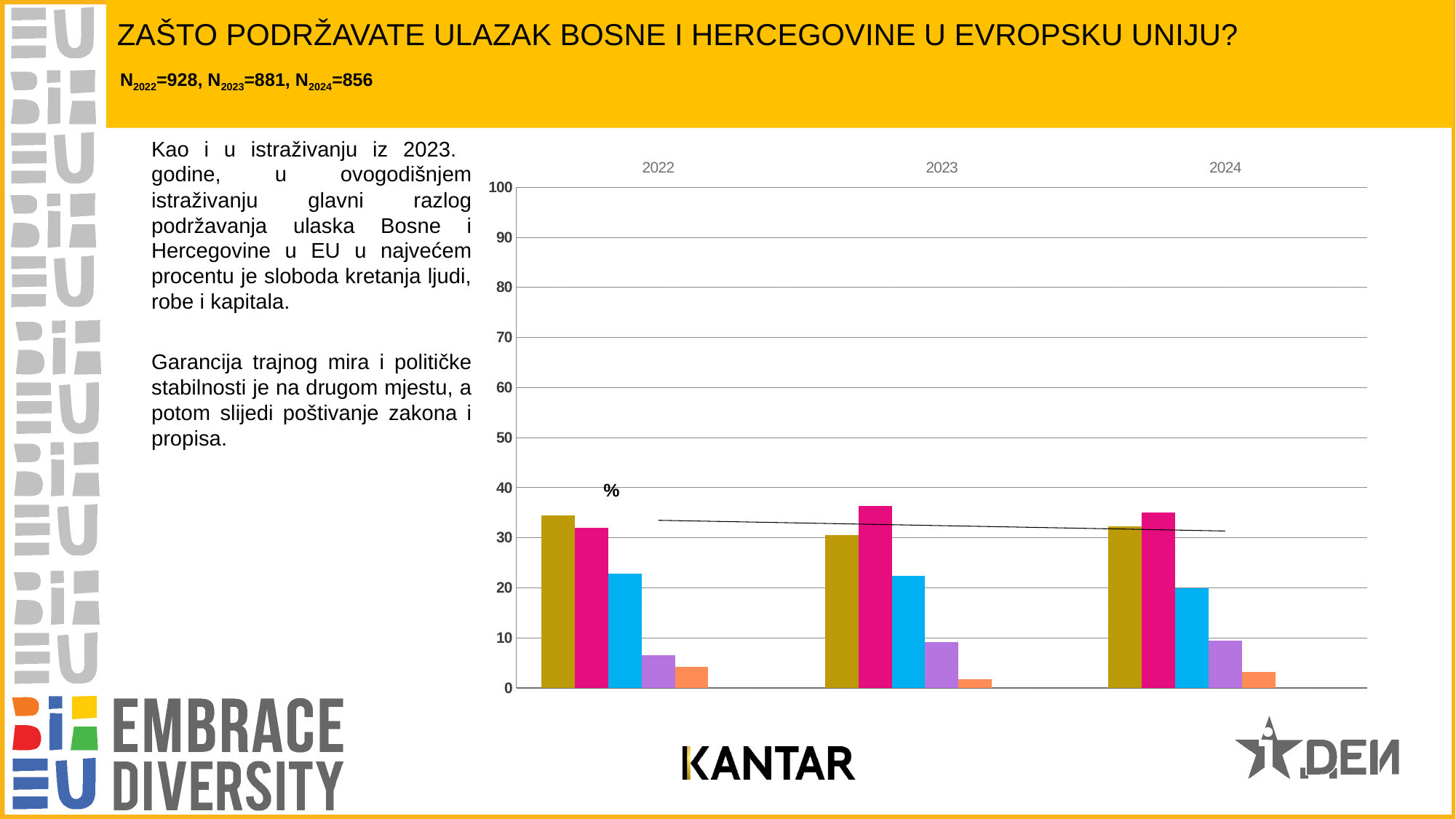
Is the value of the magenta (second) bar for 2023 greater or less than 30? greater How many year groups are shown on the x axis of the chart? 3 In the 2023 group, which bar is the shortest? the orange (fifth) bar What kind of chart is shown on the slide? bar chart Is the value of the gold (first) bar for 2022 greater or less than 30? greater Is the value of the orange (fifth) bar for 2023 greater or less than 10? less In the 2023 group, which is larger: the gold (first) bar or the magenta (second) bar? the magenta (second) bar What is the highest value shown on the chart's vertical axis? 100 How many bars are plotted in each year group of the chart? 5 In the 2023 group, which bar is the tallest? the magenta (second) bar